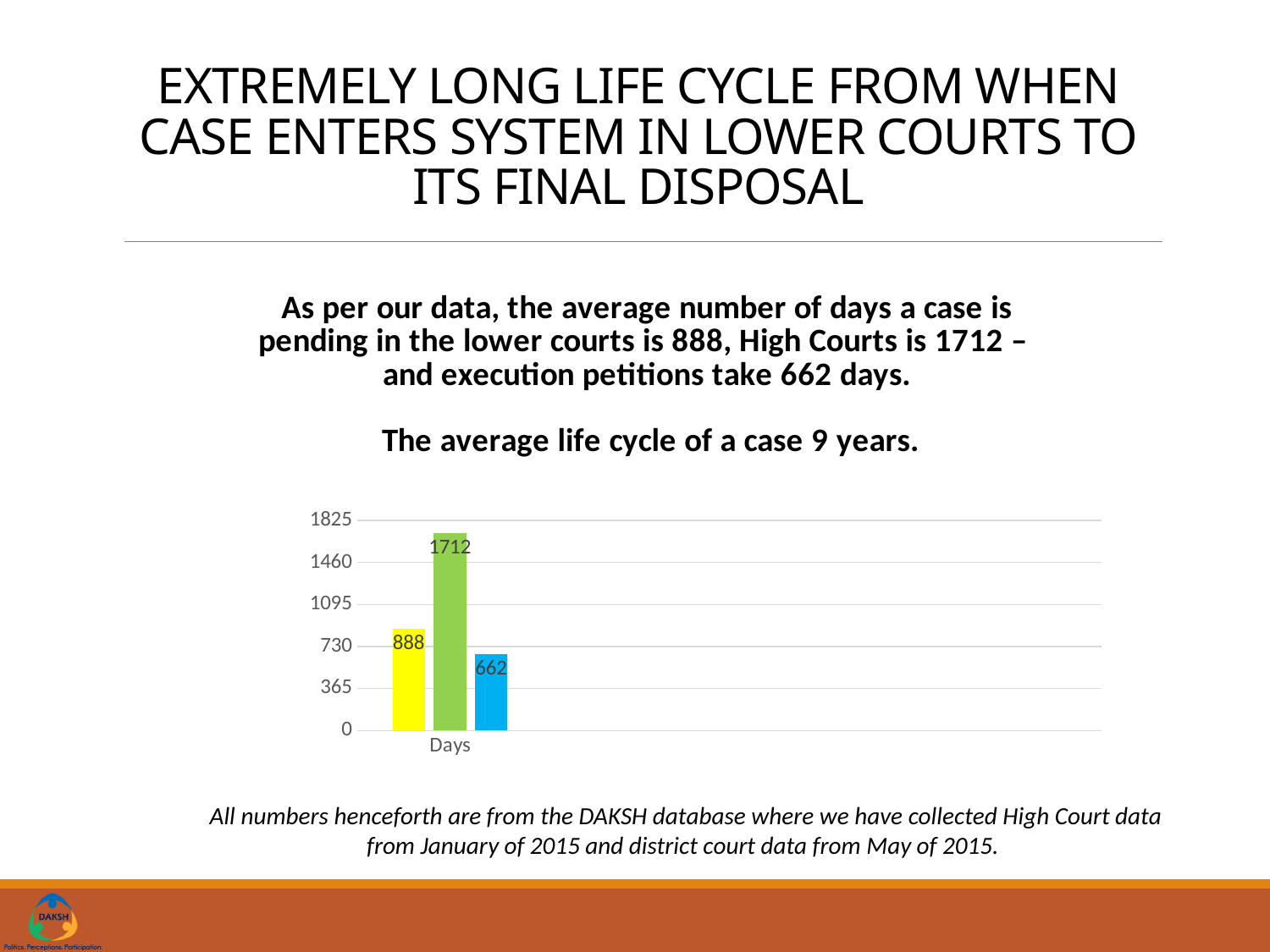
What is the value shown on the blue bar in the chart? 662 How many bars are plotted in the chart? 3 Which bar has the lowest value in the chart? the blue bar (662) Which is larger, the yellow bar's value or the blue bar's value? the yellow bar (888) What is the difference between the green bar's value and the yellow bar's value? 824 What is the value shown on the yellow bar in the chart? 888 What type of chart is shown on the slide? bar chart What is the difference between the yellow bar's value and the blue bar's value? 226 Which bar has the highest value in the chart? the green bar (1712) What is the category label shown on the x axis of the chart? Days What is the highest value shown on the y axis of the chart? 1825 What is the value shown on the green bar in the chart? 1712